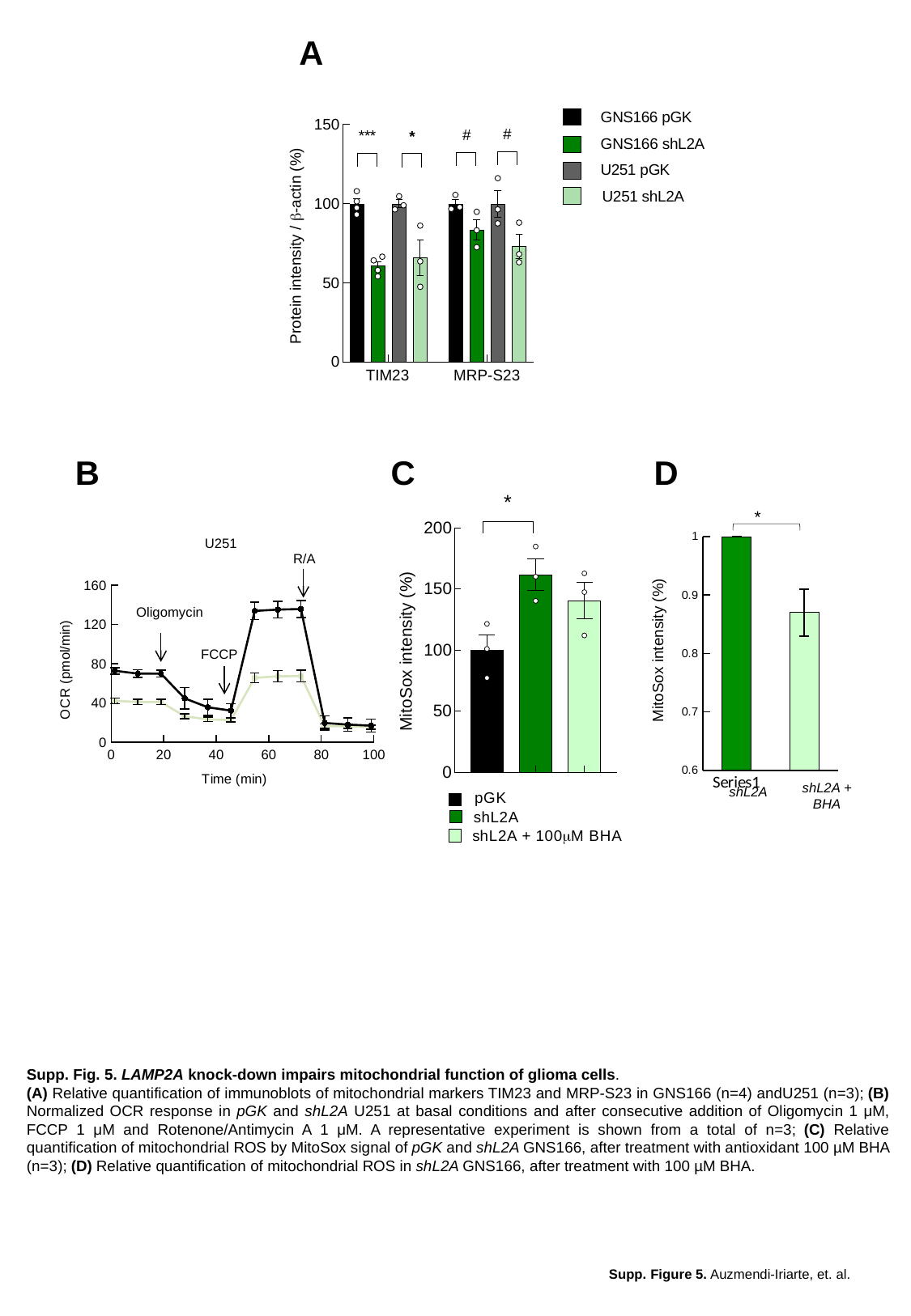
In chart C (MitoSox intensity), which bar is the lowest? pGK In chart A (Protein intensity / β-actin), how many series does the legend list? 4 In chart A (Protein intensity / β-actin), how many categories are shown on the x axis? 2 In chart A (Protein intensity / β-actin), is the value for GNS166 shL2A in the MRP-S23 group greater or less than 100? less In chart A (Protein intensity / β-actin), is the value for GNS166 shL2A in the TIM23 group greater or less than 50? greater In chart C (MitoSox intensity), which bar is the highest? shL2A In chart C (MitoSox intensity), how many series does the legend list? 3 What kind of chart is chart B (OCR vs Time)? line chart In chart D (MitoSox intensity), is the value for shL2A + BHA greater or less than 0.9? less In chart A (Protein intensity / β-actin), which is larger for TIM23: GNS166 pGK or GNS166 shL2A? GNS166 pGK